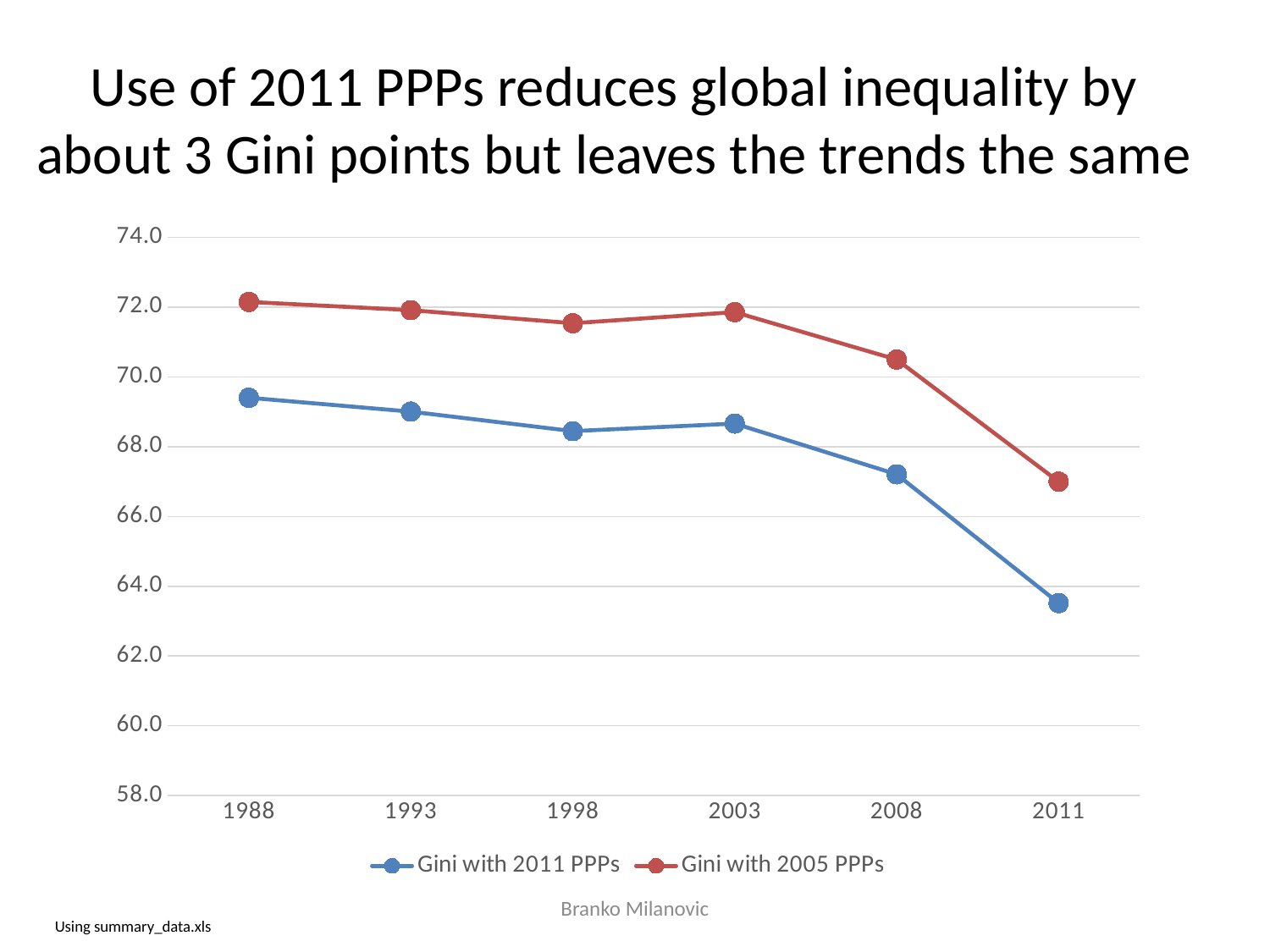
Do the values for Gini with 2005 PPPs rise or fall overall from 1988 to 2011? fall Which series is higher in 2008, Gini with 2011 PPPs or Gini with 2005 PPPs? Gini with 2005 PPPs In which year is the Gini with 2005 PPPs series at its lowest? 2011 In which year is the Gini with 2011 PPPs series at its highest? 1988 What colour is the line for Gini with 2011 PPPs? blue In which year is the Gini with 2011 PPPs series at its lowest? 2011 What kind of chart is shown on the slide? line chart How many series does the legend list? 2 Is the value for Gini with 2005 PPPs in 2008 greater or less than 70.0? greater Is the value for Gini with 2011 PPPs in 2008 greater or less than 68.0? less How many years are plotted along the x axis? 6 Is the value for Gini with 2011 PPPs in 2011 greater or less than 64.0? less